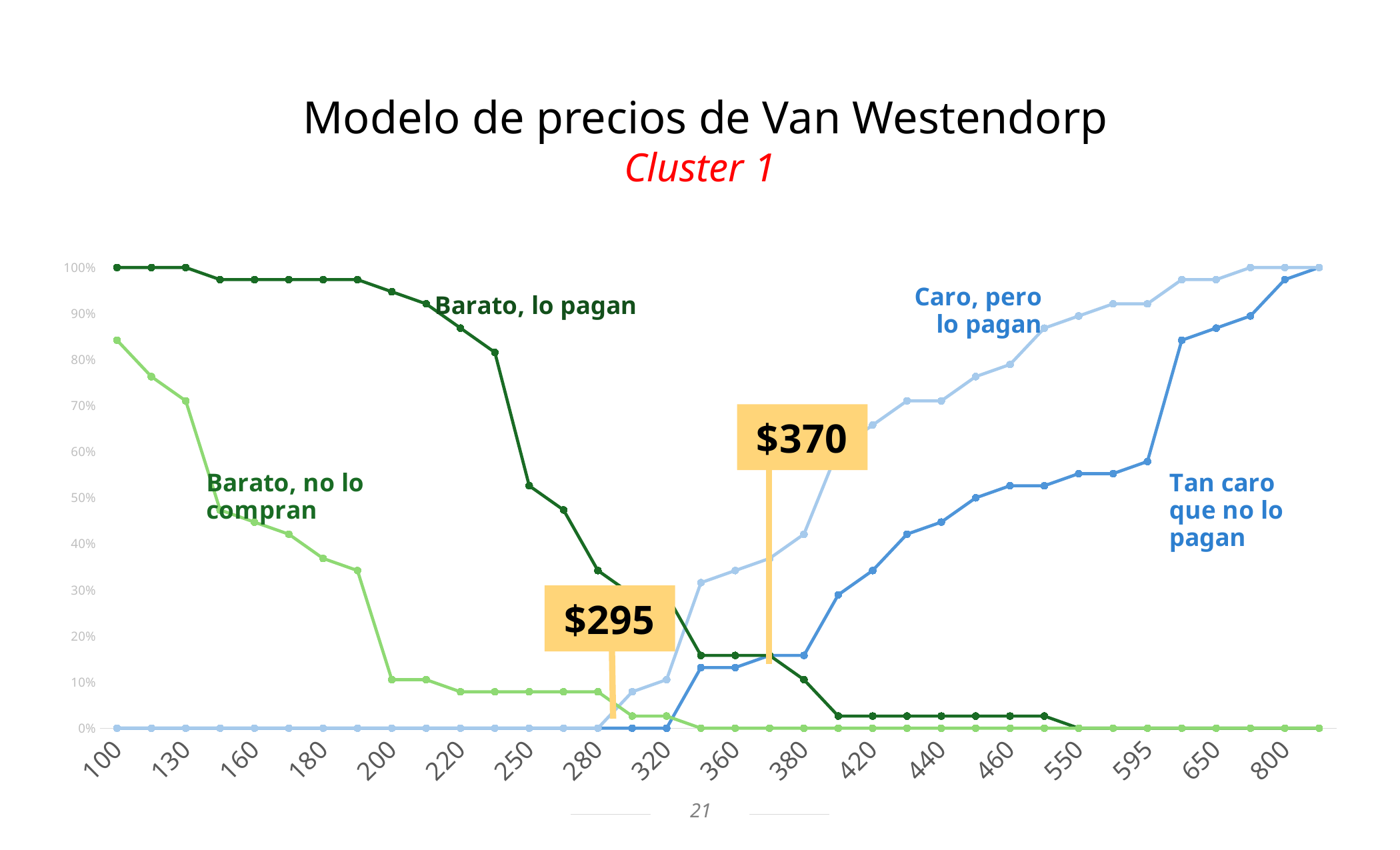
What is the value of the 'Caro, pero lo pagan' series at the price point 800? 100% What is the value of the 'Tan caro que no lo pagan' series at the price point 100? 0% What are the two price values shown in the highlighted callout boxes on the chart? $295 and $370 What is the value of the 'Barato, lo pagan' series at the price point 100? 100% Does the 'Caro, pero lo pagan' series rise or fall as the price increases along the x axis? rise What is the title of the chart on the slide? Modelo de precios de Van Westendorp At the price point 800, which series is higher: 'Barato, lo pagan' or 'Caro, pero lo pagan'? Caro, pero lo pagan How many series are labelled on the chart? 4 What kind of chart is shown on the slide? line chart Which cluster does the chart subtitle refer to? Cluster 1 Does the 'Barato, lo pagan' series rise or fall as the price increases along the x axis? fall Is the value for 'Barato, no lo compran' at the price point 100 greater or less than 70%? greater